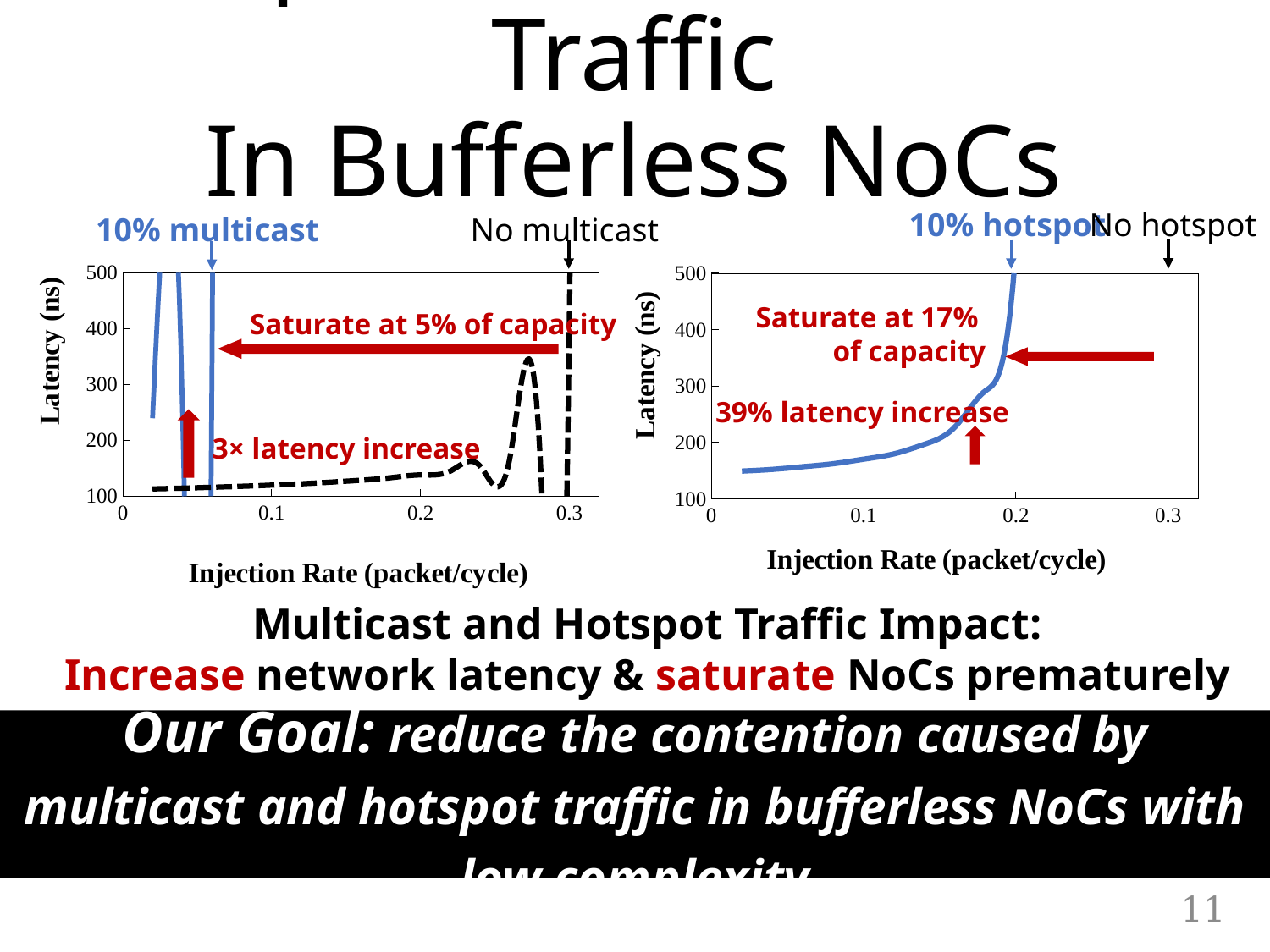
In the left chart, what latency increase is annotated for 10% multicast traffic? 3× In the right chart, what latency increase is annotated for 10% hotspot traffic? 39% In the left chart, is the latency of the No multicast series at an injection rate of 0.1 greater or less than 200? less In the right chart, at what percentage of capacity does the 10% hotspot traffic saturate, according to the annotation? 17% In the right chart, is the latency of the 10% hotspot series at an injection rate of 0.1 greater or less than 200? less In the left chart, at what percentage of capacity does the 10% multicast traffic saturate, according to the annotation? 5% What kind of chart is the right chart (hotspot)? line chart In the left chart, what is the label of the y axis? Latency (ns) What kind of chart is the left chart (multicast)? line chart How many series are shown in the left chart (multicast)? 2 In the right chart, does the latency of the 10% hotspot series rise or fall as the injection rate increases? rise In the right chart, what is the label of the x axis? Injection Rate (packet/cycle)